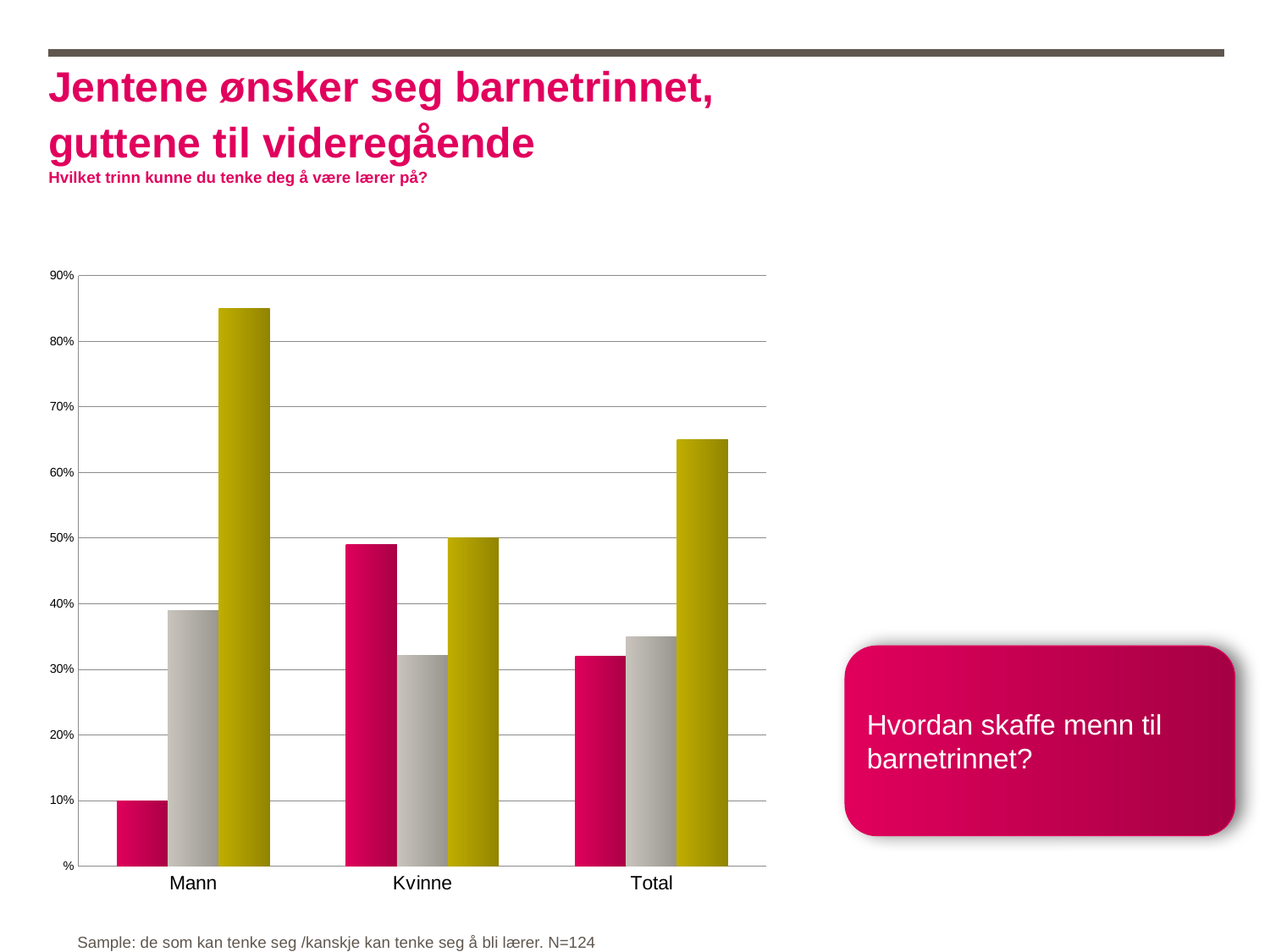
What kind of chart is shown on the slide? bar chart Is the value of the olive bar for Mann greater or less than 80%? greater How many categories are shown on the x axis of the chart? 3 What is the value of the pink bar for Mann? 10% Which category has the lowest pink bar? Mann Is the value of the pink bar for Kvinne greater or less than 40%? greater Is the value of the olive bar for Total greater or less than 60%? greater What is the value of the olive bar for Kvinne? 50% Which category has the highest olive bar? Mann What are the categories on the x axis of the chart? Mann, Kvinne, Total For Kvinne, which is larger: the pink bar or the grey bar? the pink bar